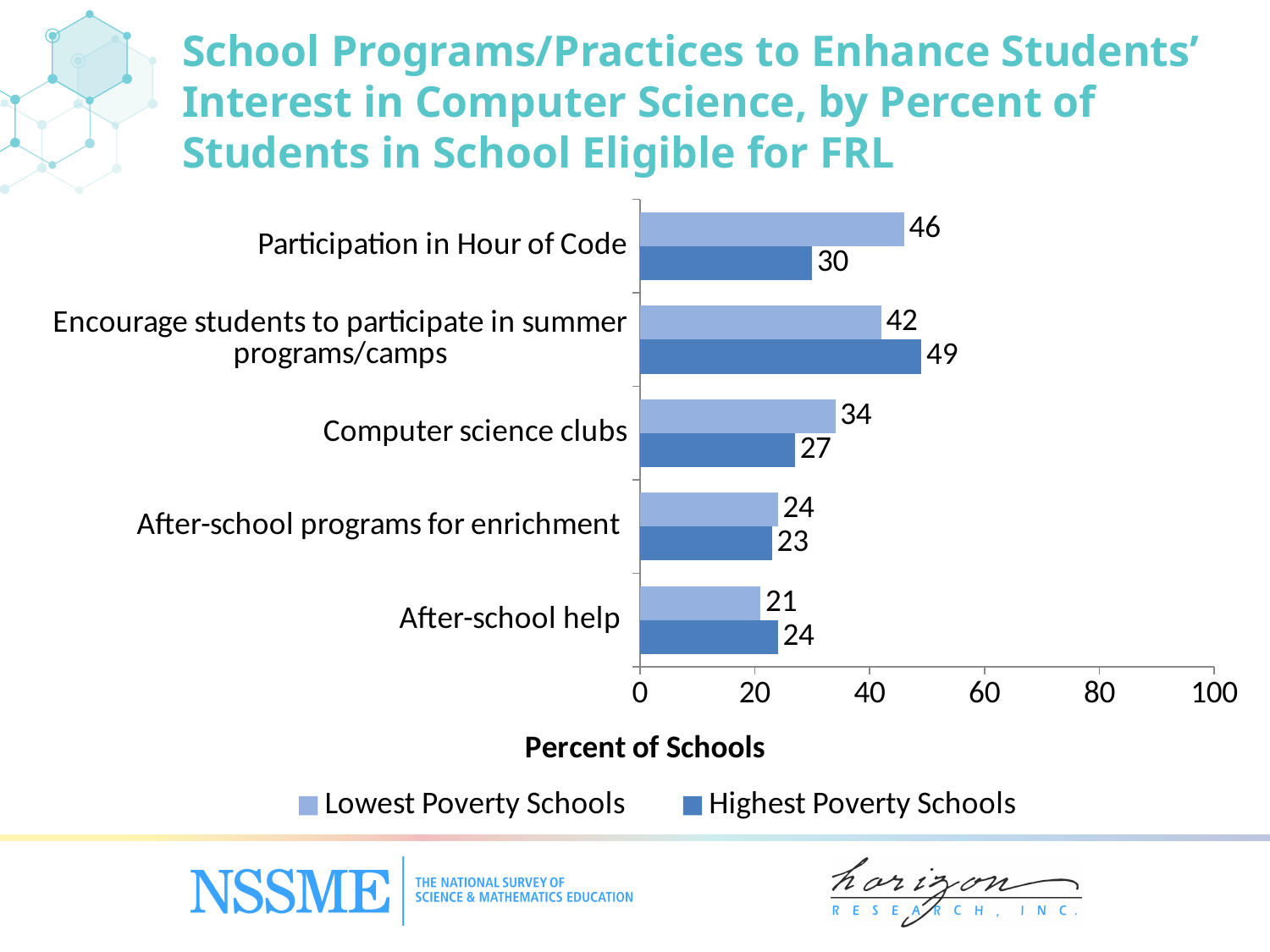
For Encourage students to participate in summer programs/camps, which series has the larger value? Highest Poverty Schools What percent of Highest Poverty Schools encourage students to participate in summer programs/camps? 49 What kind of chart is shown on the slide? Bar chart Which category has the lowest value for Highest Poverty Schools? After-school programs for enrichment Is the value for Lowest Poverty Schools for Computer science clubs greater or less than 40? less What percent of Lowest Poverty Schools report Participation in Hour of Code? 46 How many categories are shown on the chart? 5 Which category has the highest value for Lowest Poverty Schools? Participation in Hour of Code How many series does the legend list? 2 What is the difference between Lowest Poverty Schools and Highest Poverty Schools for Participation in Hour of Code? 16 What is the value for Highest Poverty Schools for Computer science clubs? 27 What is the label of the x axis? Percent of Schools